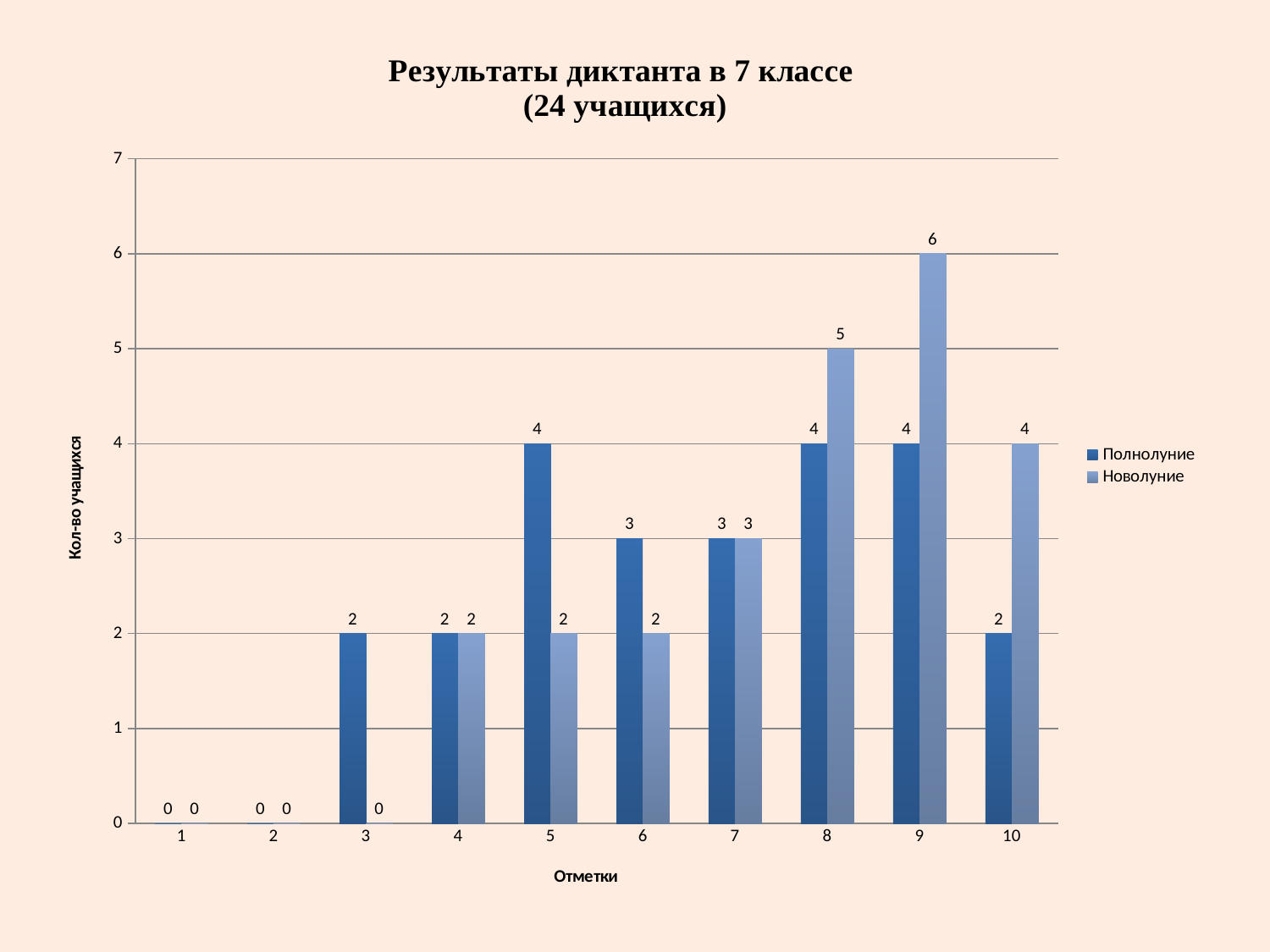
Which is larger at отметка 5: Полнолуние or Новолуние? Полнолуние What is the value for Полнолуние at отметка 5? 4 What is the value for Новолуние at отметка 9? 6 What is the title of the chart? Результаты диктанта в 7 классе (24 учащихся) What is the value for Новолуние at отметка 3? 0 What type of chart is shown on the slide? bar chart What is the label of the y axis? Кол-во учащихся Which отметка has the highest value for the Новолуние series? 9 What is the difference between Новолуние and Полнолуние at отметка 8? 1 Which is larger at отметка 10: Полнолуние or Новолуние? Новолуние How many series does the legend list? 2 How many categories (отметки) are shown on the x axis? 10